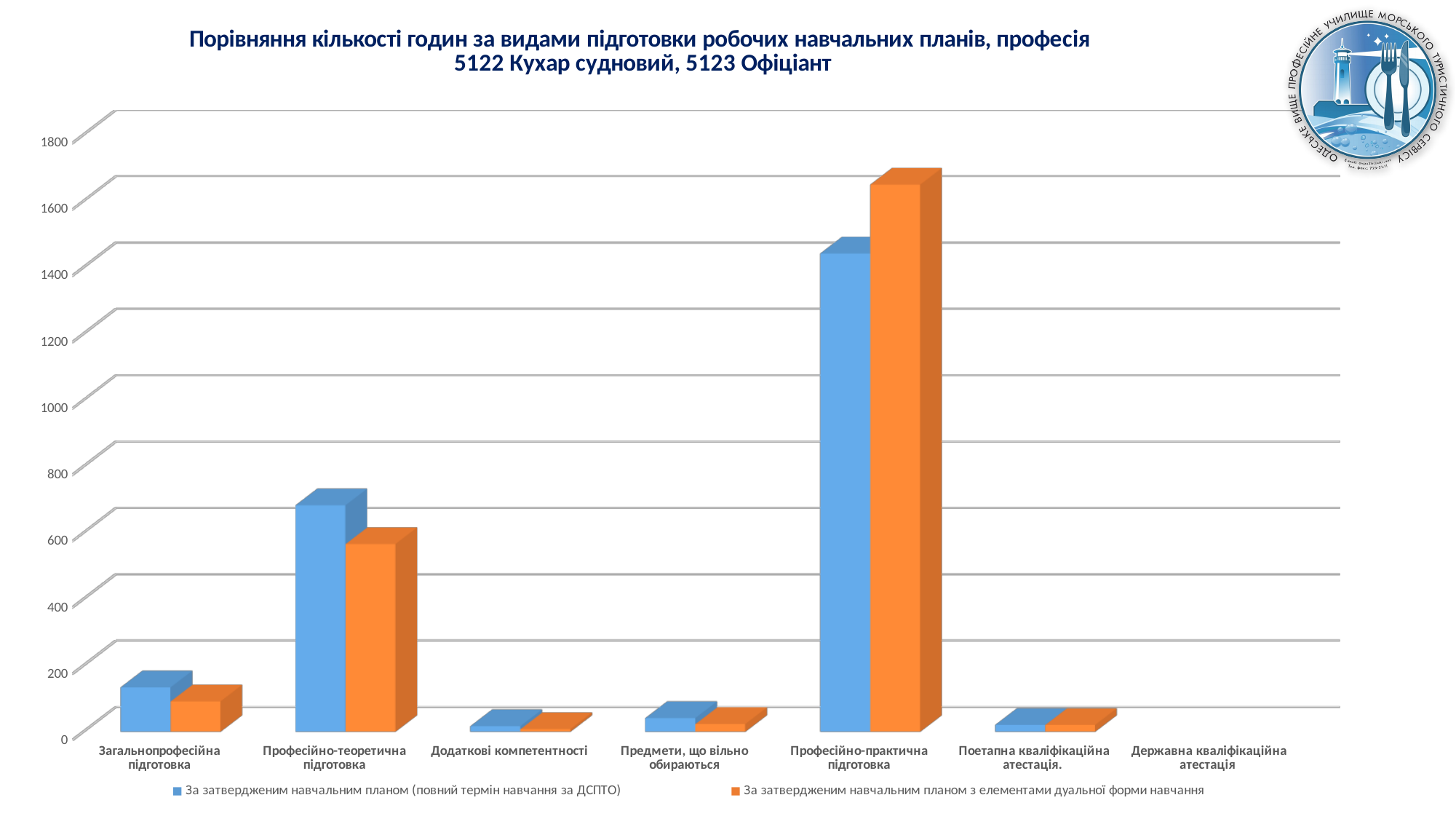
Which category has the highest value for the series 'За затвердженим навчальним планом (повний термін навчання за ДСПТО)'? Професійно-практична підготовка What colour are the bars for the series 'За затвердженим навчальним планом з елементами дуальної форми навчання'? Orange How many series does the legend list? 2 Is the value for 'Професійно-теоретична підготовка' in the series 'За затвердженим навчальним планом (повний термін навчання за ДСПТО)' greater or less than 800? less For 'Професійно-практична підготовка', which series has the larger value: 'За затвердженим навчальним планом (повний термін навчання за ДСПТО)' or 'За затвердженим навчальним планом з елементами дуальної форми навчання'? За затвердженим навчальним планом з елементами дуальної форми навчання How many categories are shown on the x axis of the chart? 7 What kind of chart is shown on the slide? Bar chart For 'Професійно-теоретична підготовка', which series has the larger value: 'За затвердженим навчальним планом (повний термін навчання за ДСПТО)' or 'За затвердженим навчальним планом з елементами дуальної форми навчання'? За затвердженим навчальним планом (повний термін навчання за ДСПТО) Is the value for 'Професійно-практична підготовка' in the series 'За затвердженим навчальним планом (повний термін навчання за ДСПТО)' greater or less than 1200? greater Is the value for 'Загальнопрофесійна підготовка' in the series 'За затвердженим навчальним планом (повний термін навчання за ДСПТО)' greater or less than 200? less Which category has the highest value for the series 'За затвердженим навчальним планом з елементами дуальної форми навчання'? Професійно-практична підготовка